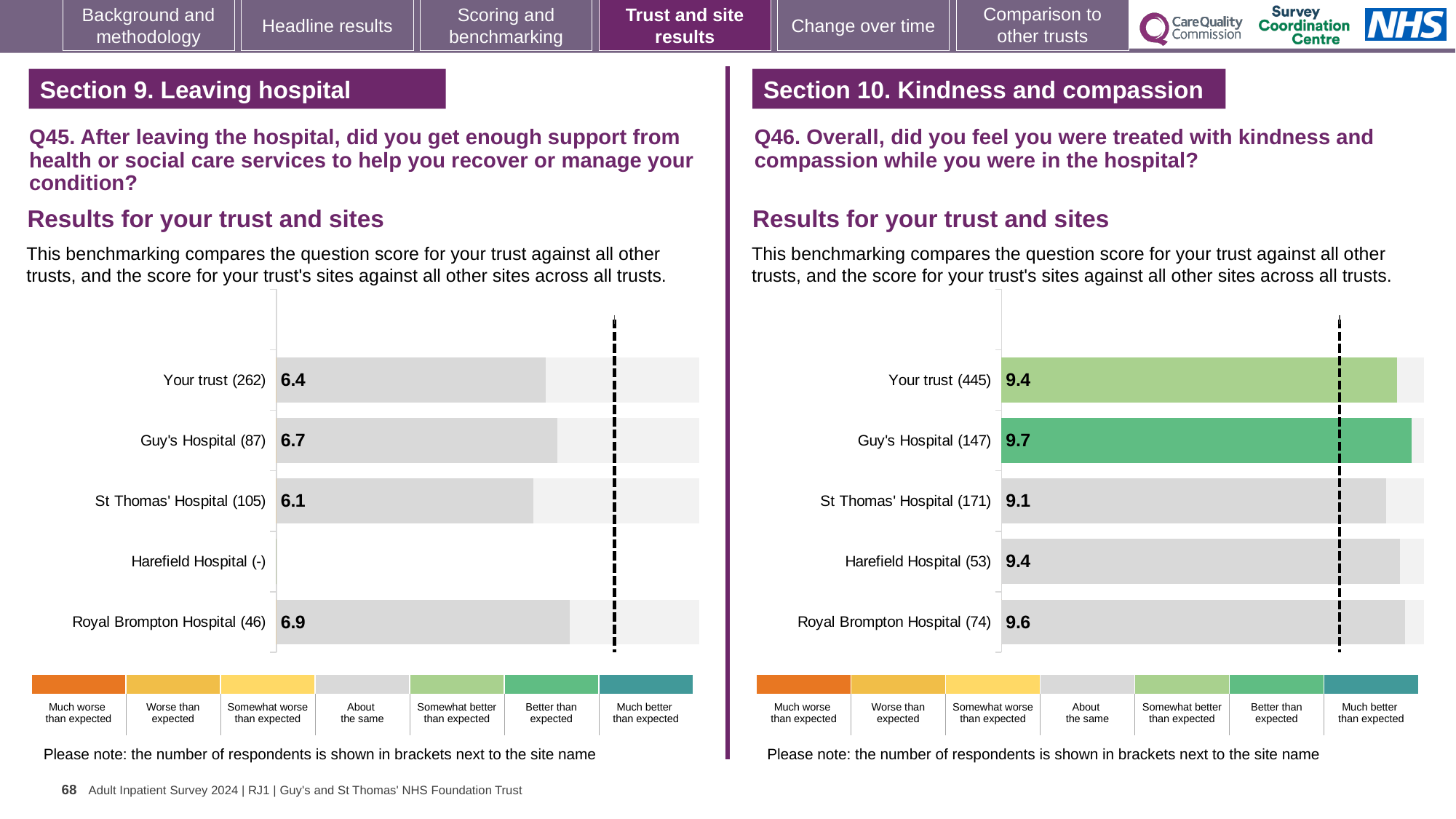
What kind of chart is used for the Q45 results on the left? Bar chart In the Q45 chart on the left, what is the difference between the scores for Guy's Hospital and St Thomas' Hospital? 0.6 In the Q45 chart on the left, how many respondents are shown for Your trust? 262 How many rows (trust and sites) are listed in the Q46 chart on the right? 5 In the Q46 chart on the right, what is the score for St Thomas' Hospital? 9.1 In the Q46 chart on the right, which is larger, the score for Royal Brompton Hospital or the score for Harefield Hospital? Royal Brompton Hospital In the Q46 chart on the right, what is the score for Guy's Hospital? 9.7 In the Q46 chart on the right, what is the difference between the scores for Guy's Hospital and Your trust? 0.3 In the Q46 chart on the right, which site has the highest score? Guy's Hospital In the Q45 chart on the left, what is the score for Royal Brompton Hospital? 6.9 In the Q45 chart on the left, which site has the lowest score? St Thomas' Hospital In the Q45 chart on the left, what is the score for Your trust? 6.4